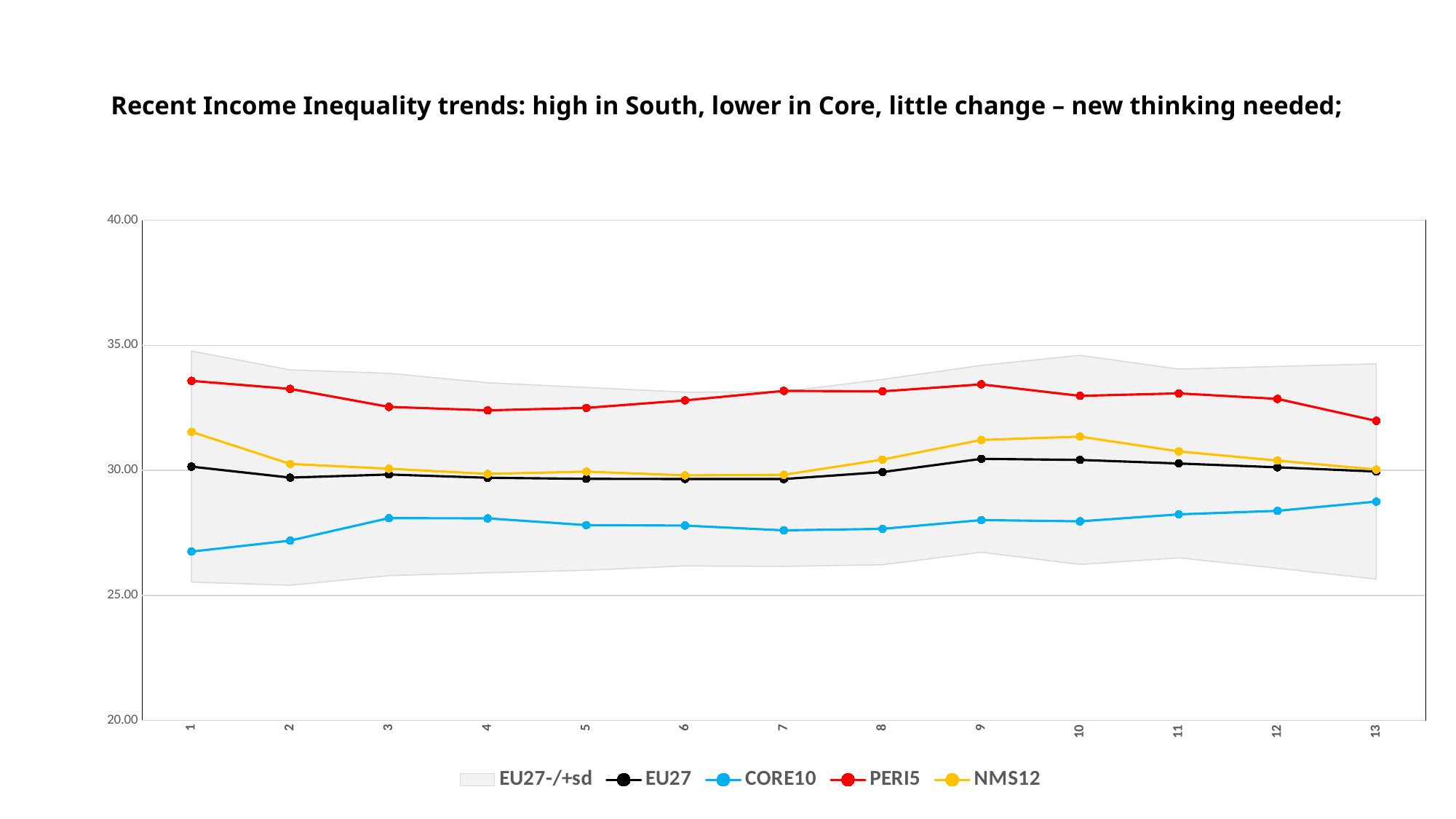
Is the value for NMS12 at point 1 greater or less than 30.00? greater Which series has the lowest value at point 13? CORE10 Is the value for PERI5 at point 1 greater or less than 30.00? greater At point 7, which is larger: the value for PERI5 or the value for CORE10? PERI5 How many series does the legend list? 5 Does the CORE10 line rise or fall overall from point 1 to point 13? rise What kind of chart is shown on the slide? line chart Which series has the highest value at point 1? PERI5 What colour is the PERI5 line? red How many points are plotted along the x axis for each series? 13 Is the value for CORE10 at point 1 greater or less than 30.00? less